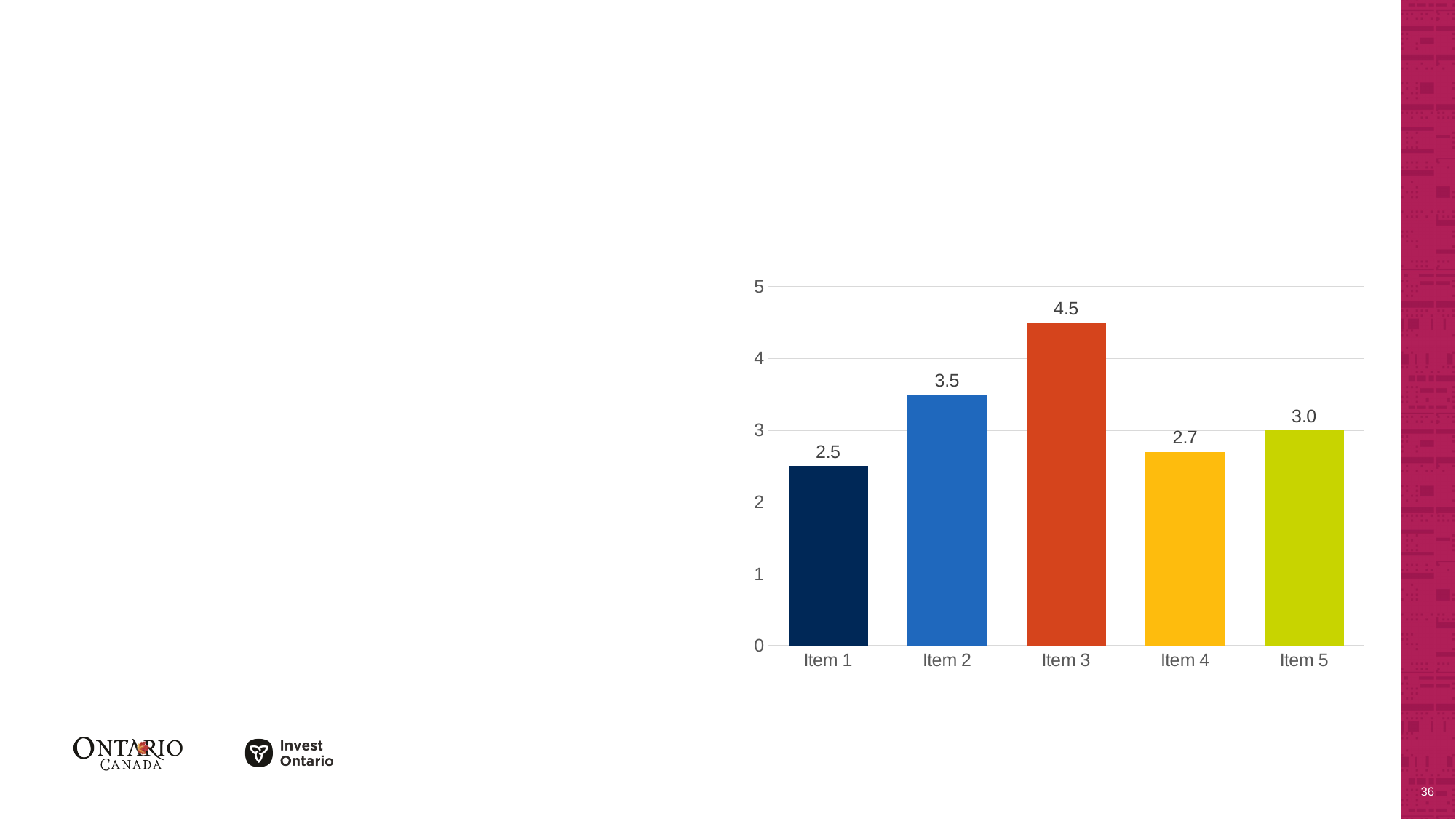
What is the difference between the values for Item 3 and Item 1? 2.0 What is the value for Item 1? 2.5 What colour is the bar for Item 3? Orange-red What is the value for Item 3? 4.5 Which item has the lowest value? Item 1 How many items are shown on the chart? 5 What kind of chart is shown on the slide? Bar chart What is the difference between the values for Item 2 and Item 4? 0.8 Is the value for Item 4 greater or less than 3? less Which is larger, the value for Item 2 or the value for Item 5? Item 2 Which item has the highest value? Item 3 What is the value for Item 5? 3.0